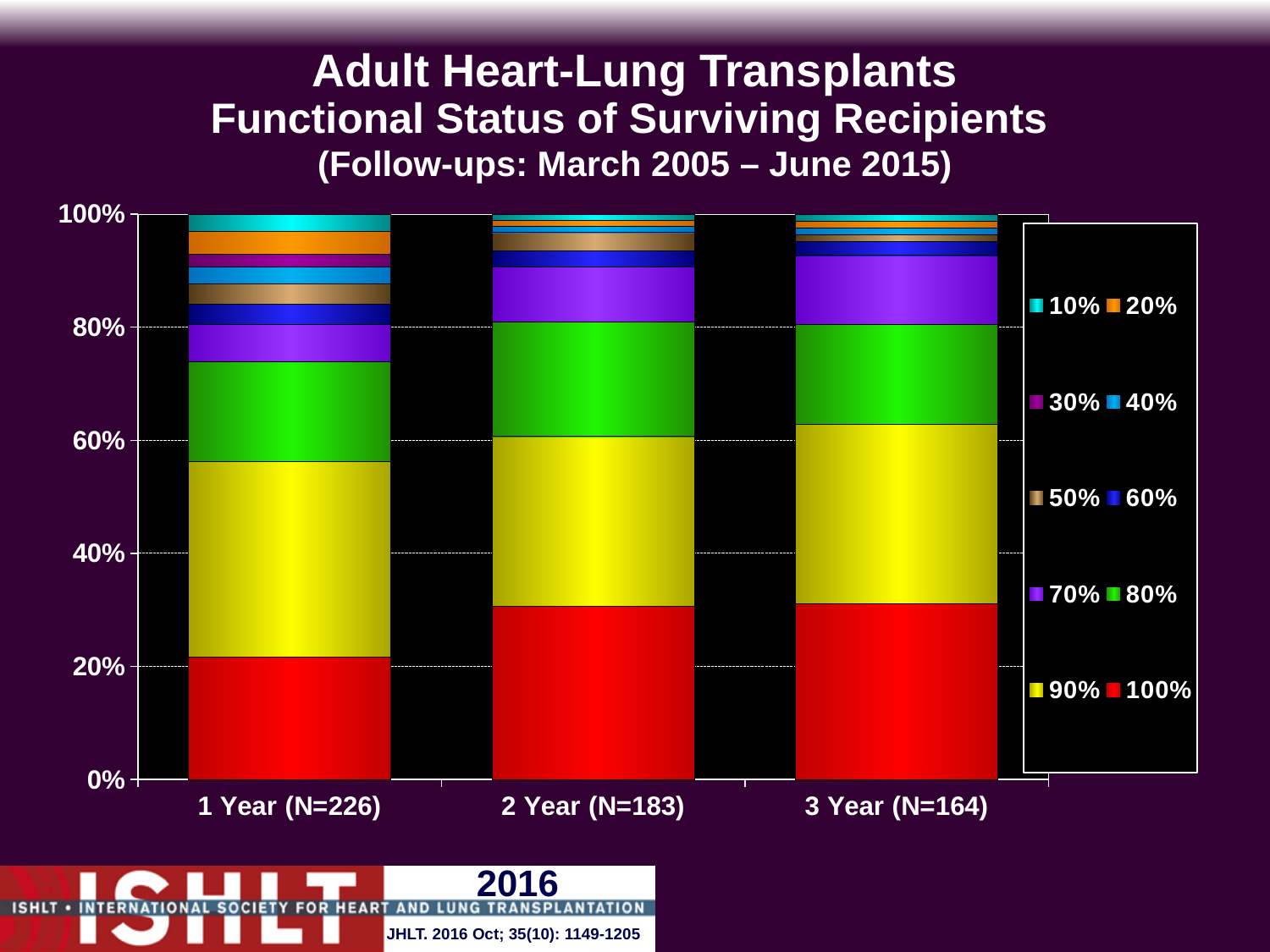
Which is larger: the 100% (red) segment for 1 Year (N=226) or for 2 Year (N=183)? 2 Year (N=183) Which category has the smallest 100% (red) segment? 1 Year (N=226) Is the 100% (red) segment for 3 Year (N=164) greater or less than 40%? less What is the N value shown for the 2 Year category? 183 What kind of chart is shown on the slide? Stacked bar chart Is the 100% (red) segment for 1 Year (N=226) greater or less than 40%? less Which category has the largest 90% (yellow) segment? 1 Year (N=226) What colour does the legend use for the 100% series? Red Is the 100% (red) segment for 2 Year (N=183) greater or less than 20%? greater How many categories are shown on the x axis? 3 What is the total height of the stacked bar for 1 Year (N=226)? 100% How many series does the legend list? 10